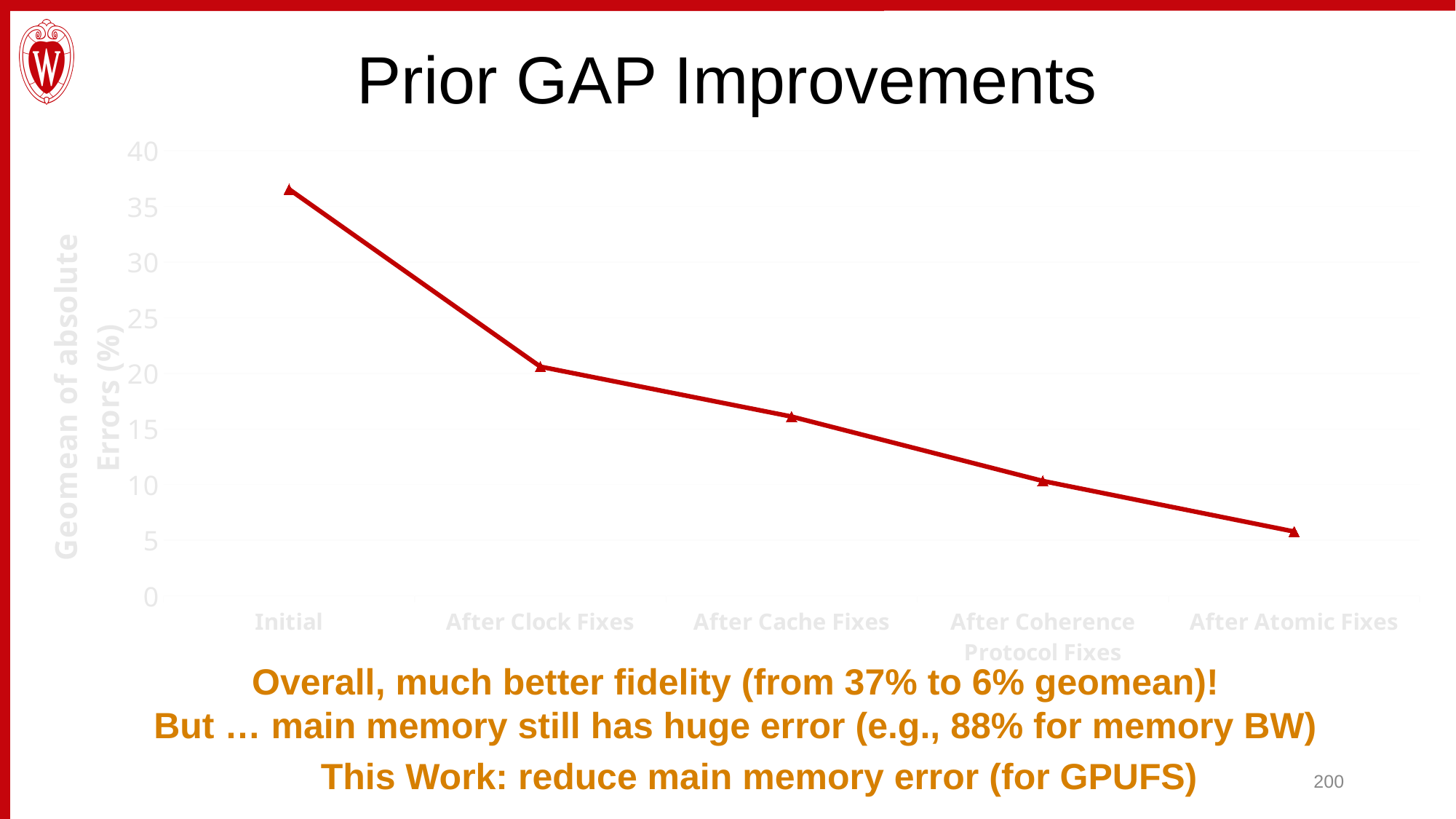
Which category has the lowest geomean of absolute errors? After Atomic Fixes Is the value for After Atomic Fixes greater or less than 10? less What kind of chart is shown on the slide? line chart Is the value for Initial greater or less than 35? greater Is the value for After Coherence Protocol Fixes greater or less than 15? less Do the values rise or fall from left to right along the x axis? fall How many categories are plotted along the x axis of the chart? 5 Which is larger, the value for After Clock Fixes or the value for After Cache Fixes? After Clock Fixes What is the title of the chart? Prior GAP Improvements Which category has the highest geomean of absolute errors? Initial